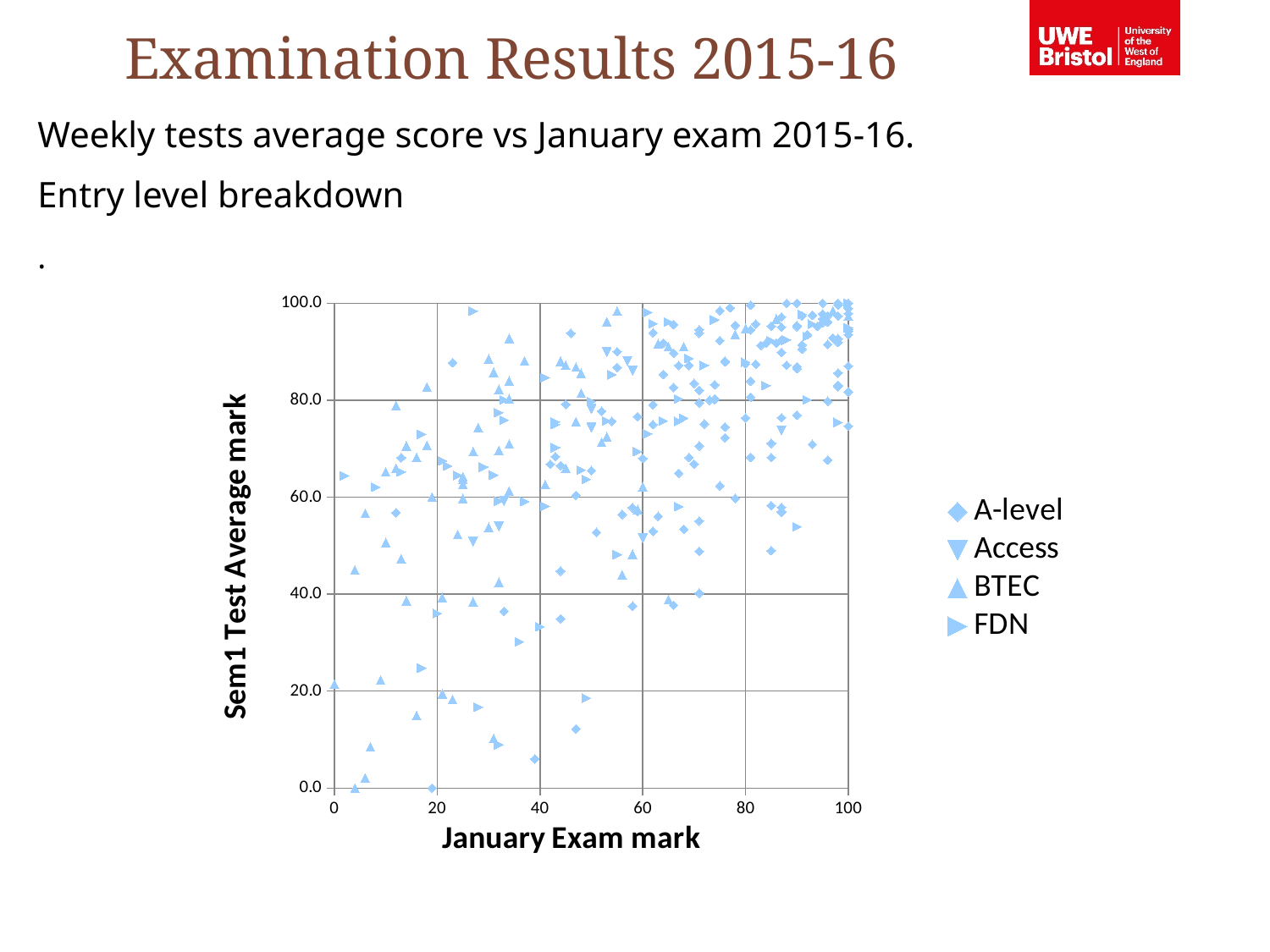
Do the Sem1 Test Average marks generally rise or fall as the January Exam mark increases? Rise What is the title of the horizontal axis of the chart? January Exam mark What kind of chart is shown on the slide? Scatter chart How many series does the chart's legend list? 4 Which series are listed in the chart's legend? A-level, Access, BTEC, FDN What is the highest value shown on the horizontal axis of the chart? 100 What is the highest value shown on the vertical axis of the chart? 100.0